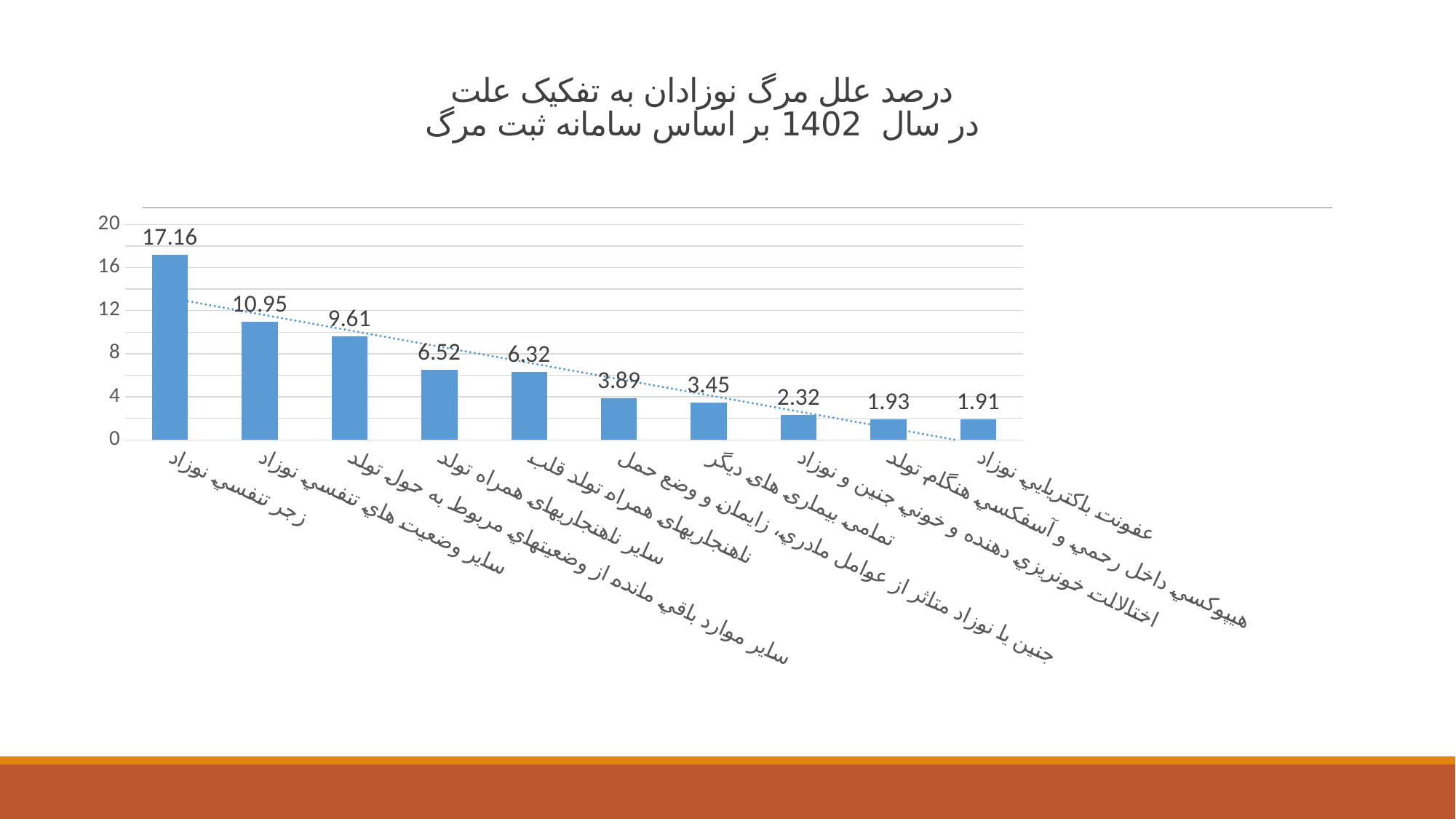
What type of chart is shown on the slide? bar chart Which is larger: the value for تمامی بیماری های دیگر or the value for اختلالات خونریزی دهنده و خونی جنین و نوزاد? تمامی بیماری های دیگر Do the bar values rise or fall from left to right along the x axis? fall What is the value for زجر تنفسي نوزاد? 17.16 What is the value for عفونت باکتریایی نوزاد? 1.91 Which category has the highest value? زجر تنفسي نوزاد What is the title of the chart? درصد علل مرگ نوزادان به تفکیک علت در سال 1402 بر اساس سامانه ثبت مرگ What is the value for ناهنجاریهای همراه تولد قلب? 6.32 Which category has the lowest value? عفونت باکتریایی نوزاد What is the difference between the values for زجر تنفسي نوزاد and سایر وضعیت های تنفسی نوزاد? 6.21 How many categories (causes of death) are plotted in the chart? 10 What is the value for سایر وضعیت های تنفسی نوزاد? 10.95